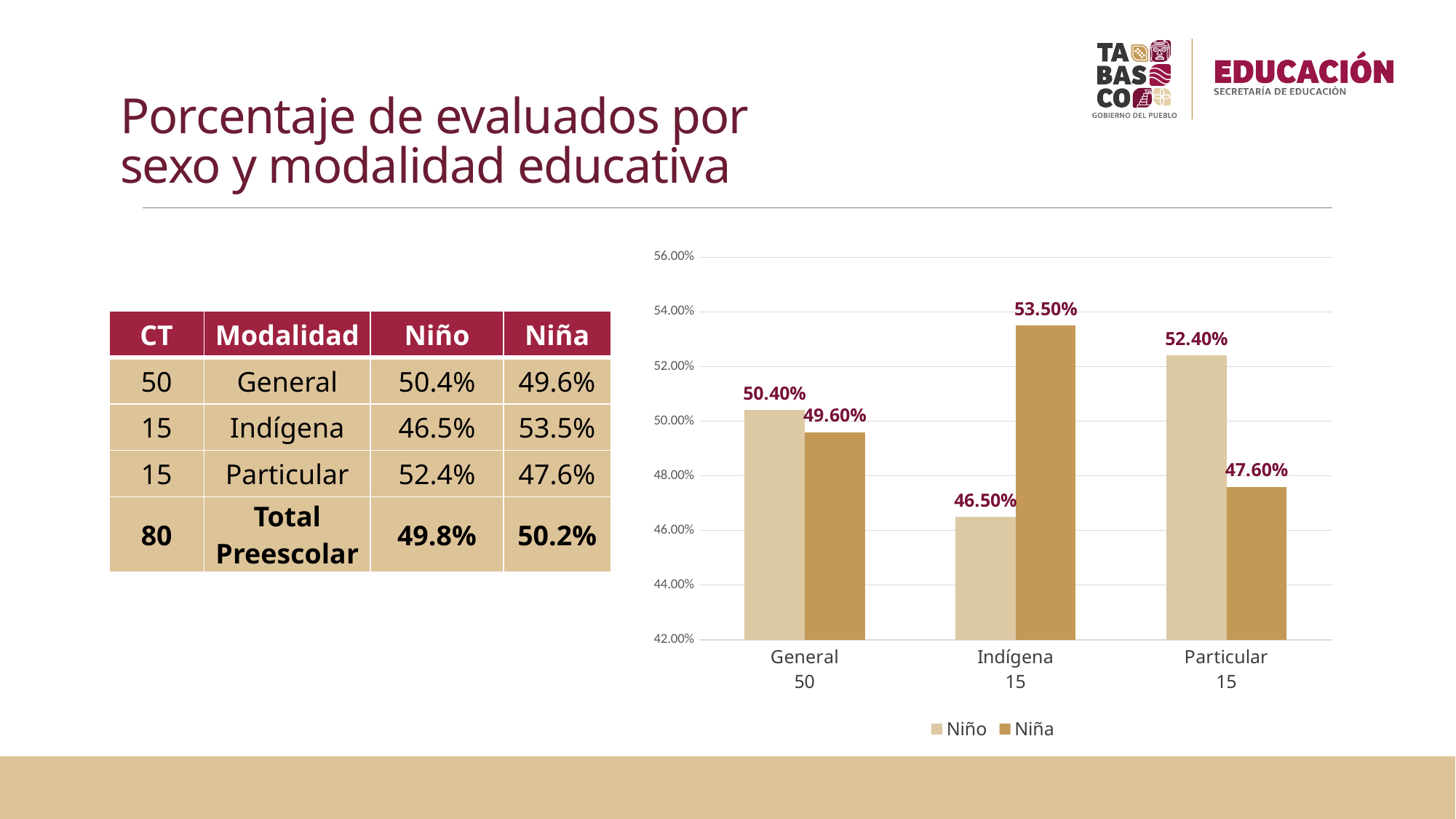
How many categories are shown on the x axis? 3 What is the value for Niña in the Particular category? 47.60% What is the value for Niña in the Indígena category? 53.50% Which category has the highest Niña value? Indígena Which category has the lowest Niño value? Indígena Which is larger in the Particular category, Niño or Niña? Niño What is the difference between the Niña and Niño values in the Indígena category? 7.00% What kind of chart is shown? bar chart Is the Niño value for Indígena greater or less than 48.00%? less What are the two series named in the legend? Niño and Niña What is the value for Niño in the General category? 50.40% How many series does the legend list? 2